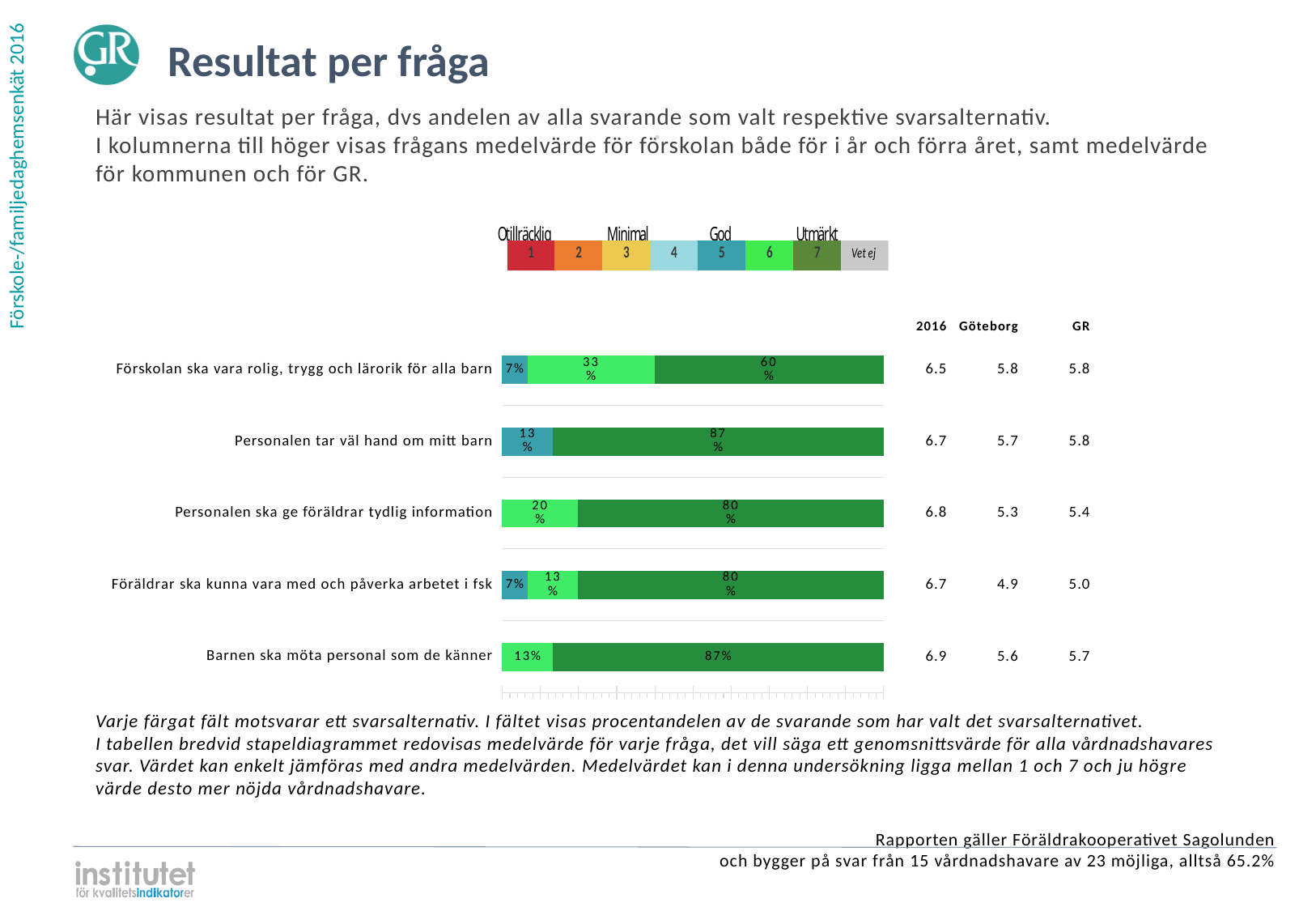
What is the total of the three segments in the bar for "Föräldrar ska kunna vara med och påverka arbetet i fsk"? 100% For "Förskolan ska vara rolig, trygg och lärorik för alla barn", what is the difference between the share choosing 7 and the share choosing 6? 27 percentage points How many answer options are shown in the colour legend above the chart, including "Vet ej"? 8 What percentage of respondents chose answer 7 for "Barnen ska möta personal som de känner"? 87% What kind of chart is used to show the results per question? Stacked bar chart Which question has the lowest share of respondents choosing answer 7 (dark green)? Förskolan ska vara rolig, trygg och lärorik för alla barn For "Föräldrar ska kunna vara med och påverka arbetet i fsk", which is larger: the share choosing 6 or the share choosing 5? The share choosing 6 (13%) How many questions (categories) are shown in the bar chart? 5 What percentage of respondents chose answer 7 (dark green) for "Förskolan ska vara rolig, trygg och lärorik för alla barn"? 60% What percentage of respondents chose answer 6 (light green) for "Personalen ska ge föräldrar tydlig information"? 20% What is the 2016 mean value shown for "Barnen ska möta personal som de känner"? 6.9 What percentage of respondents chose answer 5 (teal) for "Personalen tar väl hand om mitt barn"? 13%